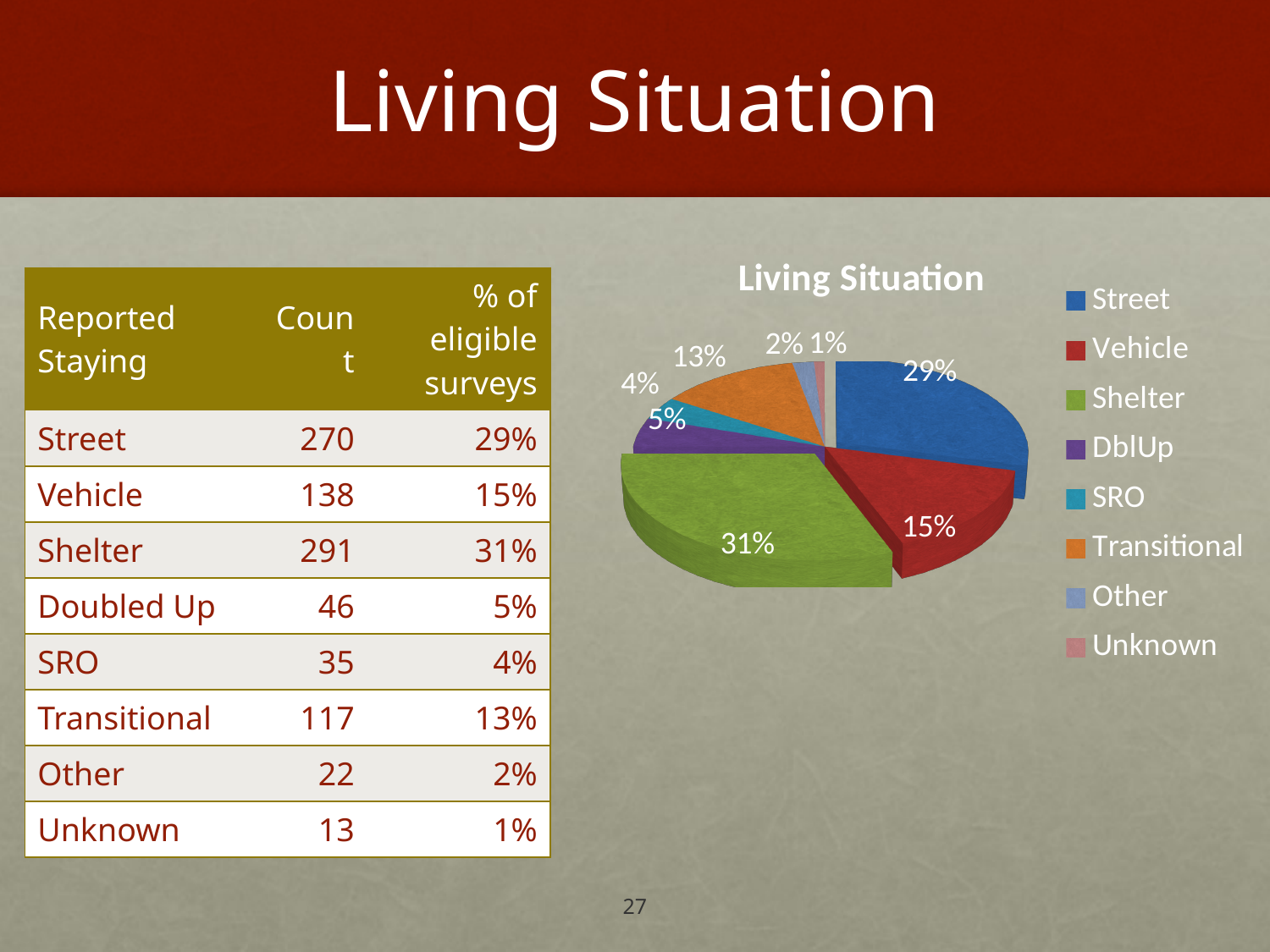
What percentage does the Shelter slice show? 31% What percentage does the Street slice show? 29% Which category has the largest slice of the pie? Shelter Which category has the smallest slice of the pie? Unknown Which legend entry is shown in green? Shelter What percentage does the Transitional slice show? 13% What is the title of the chart? Living Situation What is the difference in percentage points between the Shelter and Street slices? 2 What kind of chart is shown on the slide? pie chart How many slices does the pie chart have? 8 Which slice is larger, Vehicle or Transitional? Vehicle What percentage does the Vehicle slice show? 15%